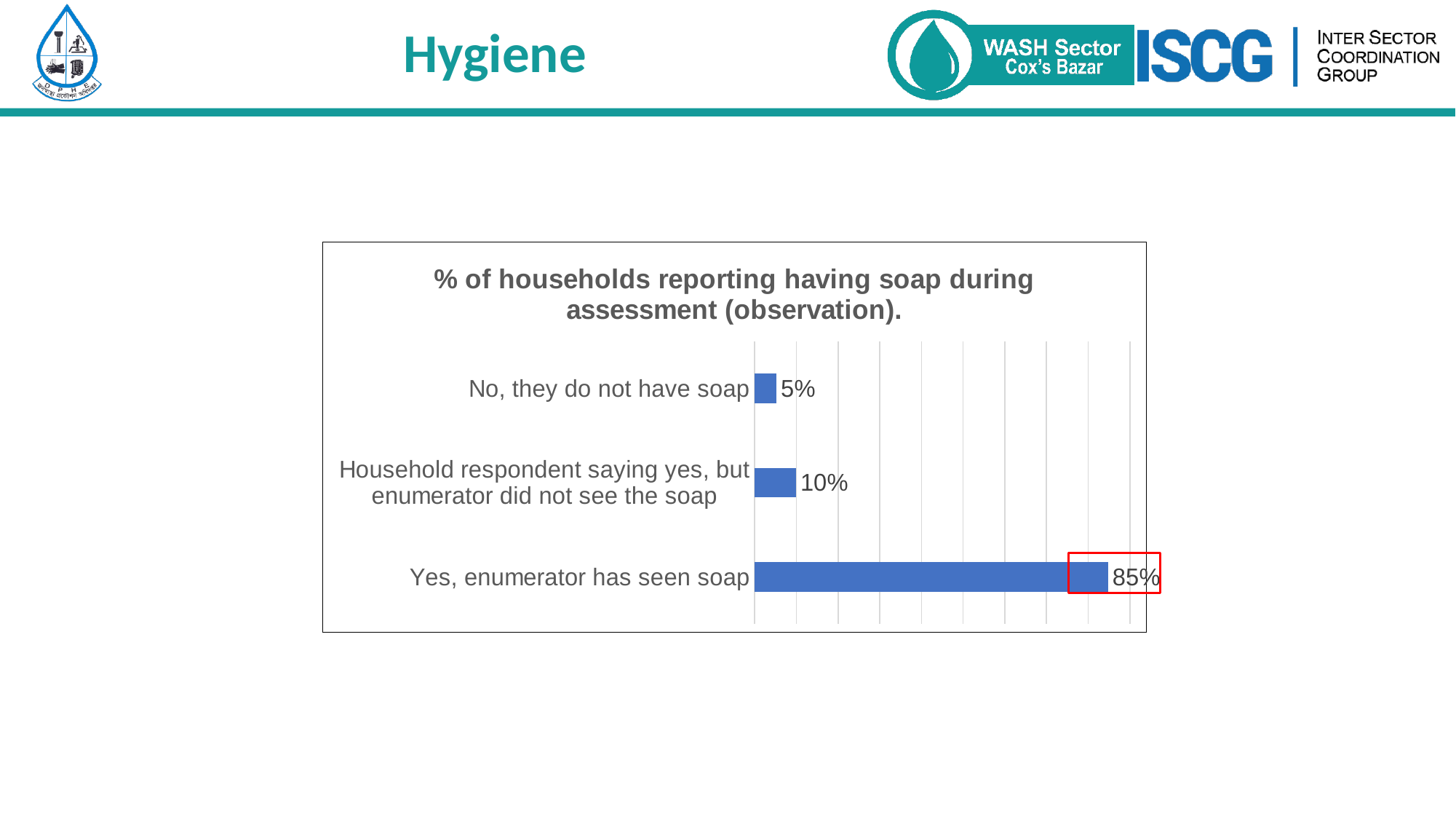
What kind of chart is shown on the slide? Bar chart Which category has the highest value? Yes, enumerator has seen soap Which category has the lowest value? No, they do not have soap What is the difference between the 'Household respondent saying yes, but enumerator did not see the soap' value and the 'No, they do not have soap' value? 5% What is the title of the chart? % of households reporting having soap during assessment (observation). What percentage of households reported not having soap? 5% Which data label on the chart is outlined with a red box? 85% What is the difference between the 'Yes, enumerator has seen soap' value and the 'No, they do not have soap' value? 80% How many categories are shown in the chart? 3 Which is larger: the value for 'No, they do not have soap' or the value for 'Household respondent saying yes, but enumerator did not see the soap'? Household respondent saying yes, but enumerator did not see the soap What percentage of households had soap that the enumerator has seen? 85% What percentage of household respondents said yes but the enumerator did not see the soap? 10%